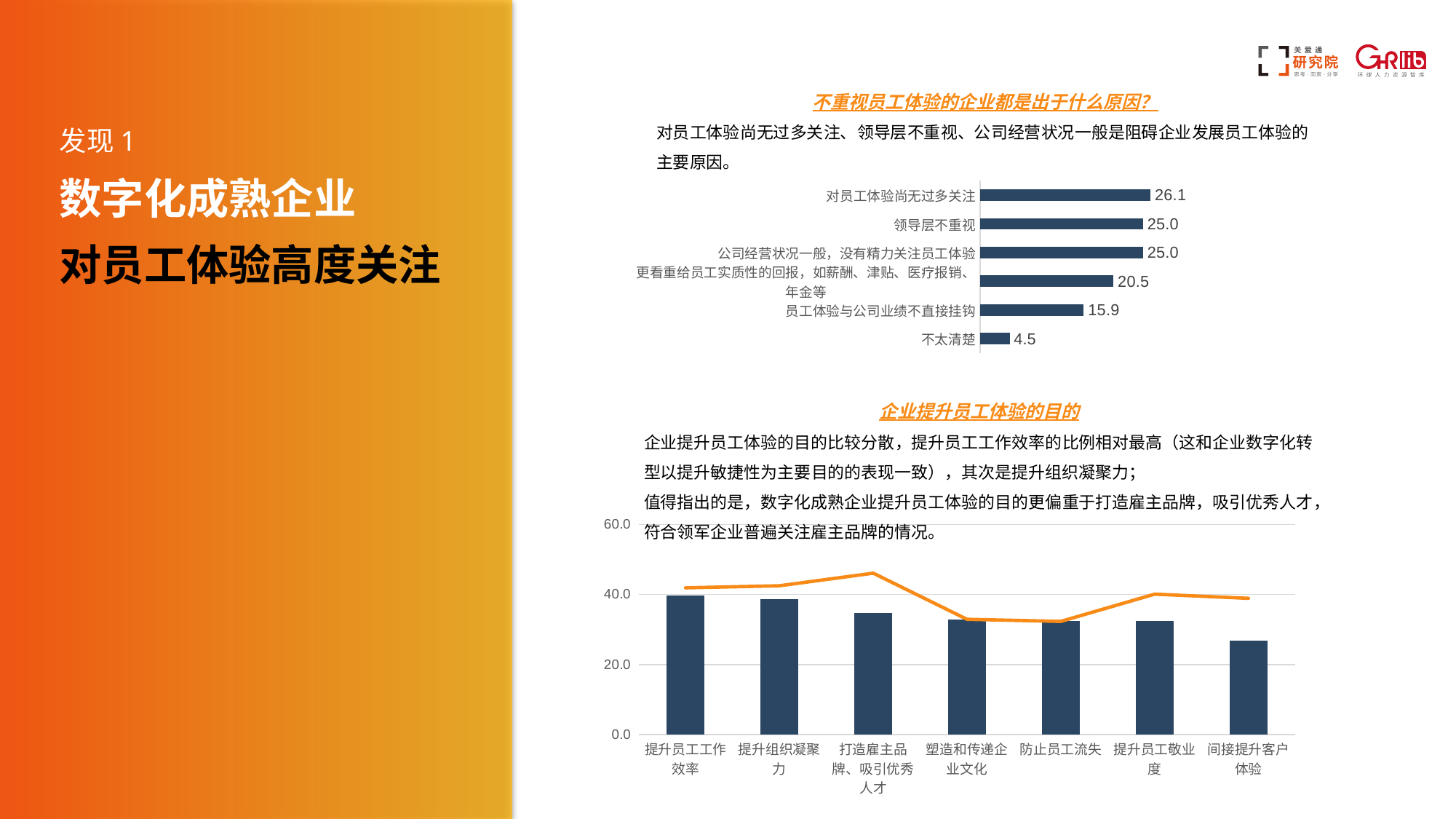
In the top chart titled 不重视员工体验的企业都是出于什么原因?, what is the difference between the values for 对员工体验尚无过多关注 and 不太清楚? 21.6 In the top chart titled 不重视员工体验的企业都是出于什么原因?, which category has the highest value? 对员工体验尚无过多关注 In the top chart titled 不重视员工体验的企业都是出于什么原因?, what is the value for 对员工体验尚无过多关注? 26.1 In the bottom chart under 企业提升员工体验的目的, how many categories are shown on the x axis? 7 What kind of chart is the top chart titled 不重视员工体验的企业都是出于什么原因? Bar chart In the top chart titled 不重视员工体验的企业都是出于什么原因?, what is the value for 不太清楚? 4.5 In the top chart titled 不重视员工体验的企业都是出于什么原因?, which category has the lowest value? 不太清楚 In the top chart titled 不重视员工体验的企业都是出于什么原因?, what is the value for 员工体验与公司业绩不直接挂钩? 15.9 In the bottom chart under 企业提升员工体验的目的, is the bar for 间接提升客户体验 greater or less than 40.0? less In the top chart titled 不重视员工体验的企业都是出于什么原因?, how many categories are shown? 6 In the bottom chart under 企业提升员工体验的目的, which category has the lowest bar? 间接提升客户体验 In the bottom chart under 企业提升员工体验的目的, is the bar for 打造雇主品牌、吸引优秀人才 greater or less than 20.0? greater